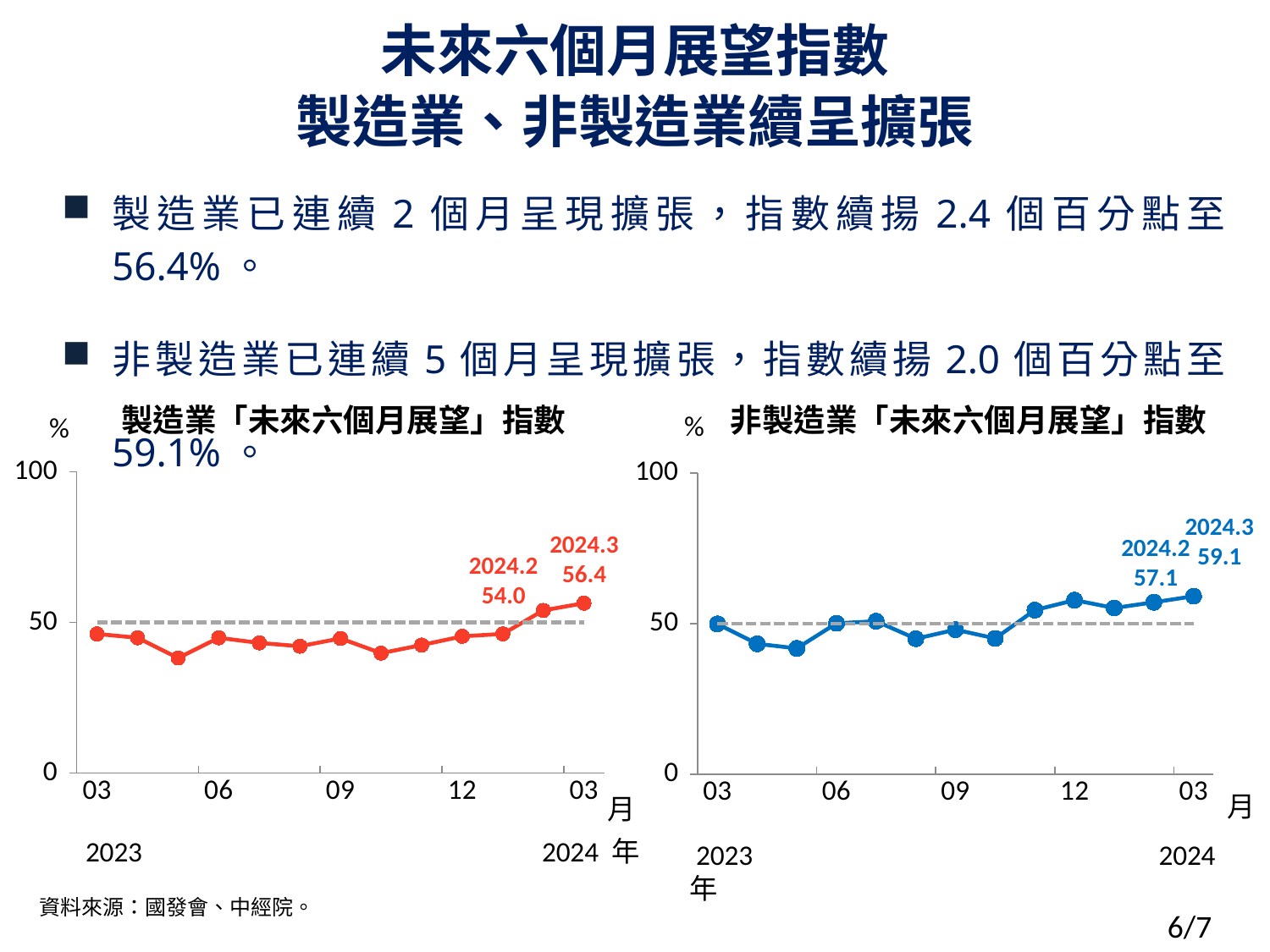
In the 非製造業「未來六個月展望」指數 chart, what is the value labelled for 2024.3? 59.1 In the 非製造業「未來六個月展望」指數 chart, what is the value labelled for 2024.2? 57.1 In the 製造業「未來六個月展望」指數 chart, what is the value labelled for 2024.2? 54.0 Which is larger for 2024.3: the 製造業 index or the 非製造業 index? 非製造業 (59.1) In the 非製造業「未來六個月展望」指數 chart, by how much did the index rise from 2024.2 to 2024.3? 2.0 What type of chart is the 非製造業「未來六個月展望」指數 chart? Line chart In the 製造業「未來六個月展望」指數 chart, by how much did the index rise from 2024.2 to 2024.3? 2.4 In the 非製造業「未來六個月展望」指數 chart, is the value for month 12 of 2023 greater or less than 50? greater In the 製造業「未來六個月展望」指數 chart, is the value for month 05 of 2023 greater or less than 50? less How many data points are plotted in the 製造業「未來六個月展望」指數 chart? 13 In the 製造業「未來六個月展望」指數 chart, what is the value labelled for 2024.3? 56.4 In the 製造業「未來六個月展望」指數 chart, at what level is the grey dashed reference line drawn? 50